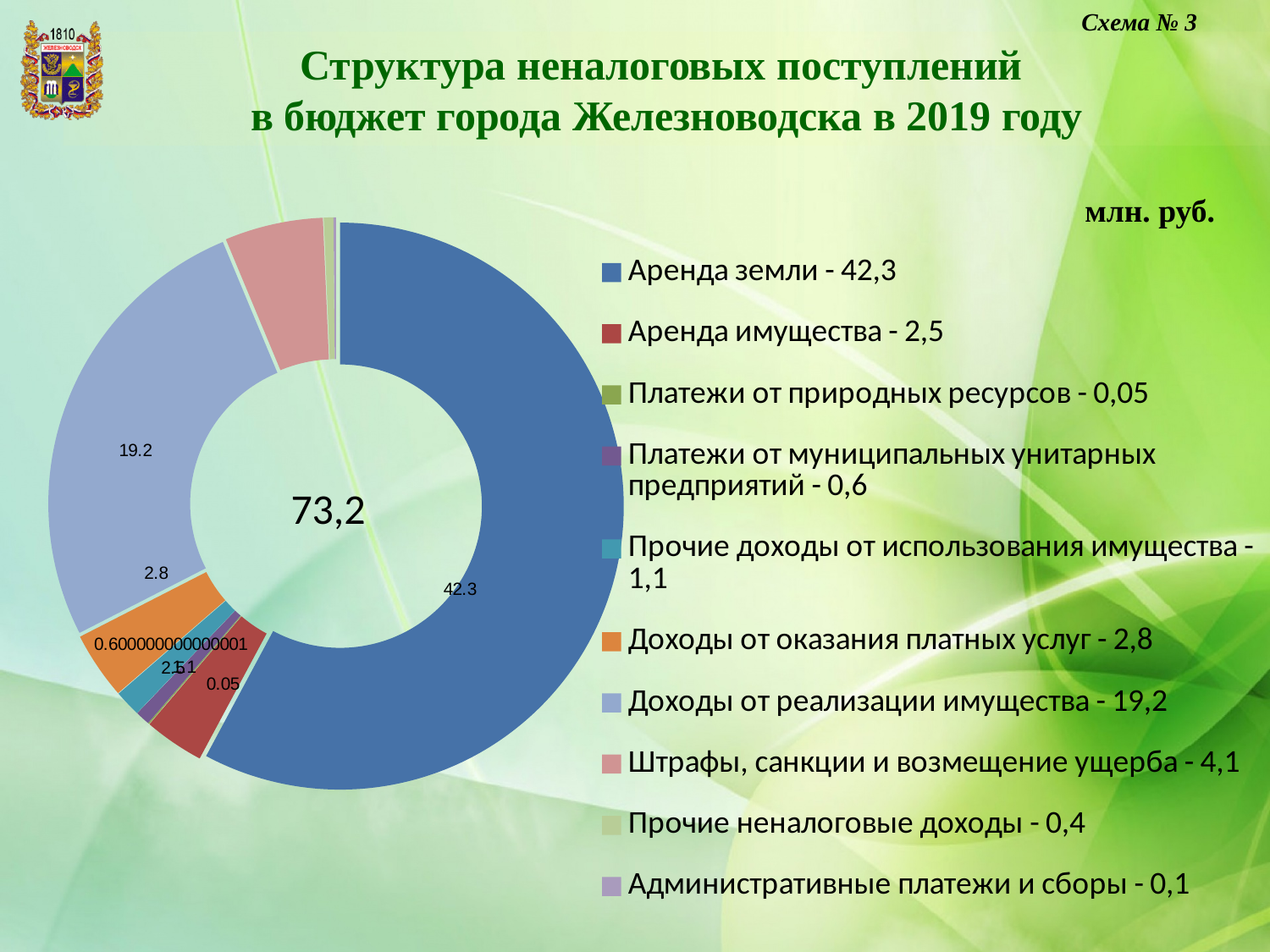
What is the value for Аренда земли? 42,3 How many categories does the legend list? 10 What unit of measurement is indicated for the chart values? млн. руб. What is the difference between Аренда земли and Доходы от реализации имущества? 23,1 What type of chart is shown on the slide? Doughnut (pie) chart What total value is shown in the centre of the chart? 73,2 What is the value for Штрафы, санкции и возмещение ущерба? 4,1 What is the value for Платежи от муниципальных унитарных предприятий? 0,6 Which category has the highest value? Аренда земли What is the value for Доходы от реализации имущества? 19,2 Which category has the lowest value? Платежи от природных ресурсов Which is larger: Доходы от оказания платных услуг or Аренда имущества? Доходы от оказания платных услуг